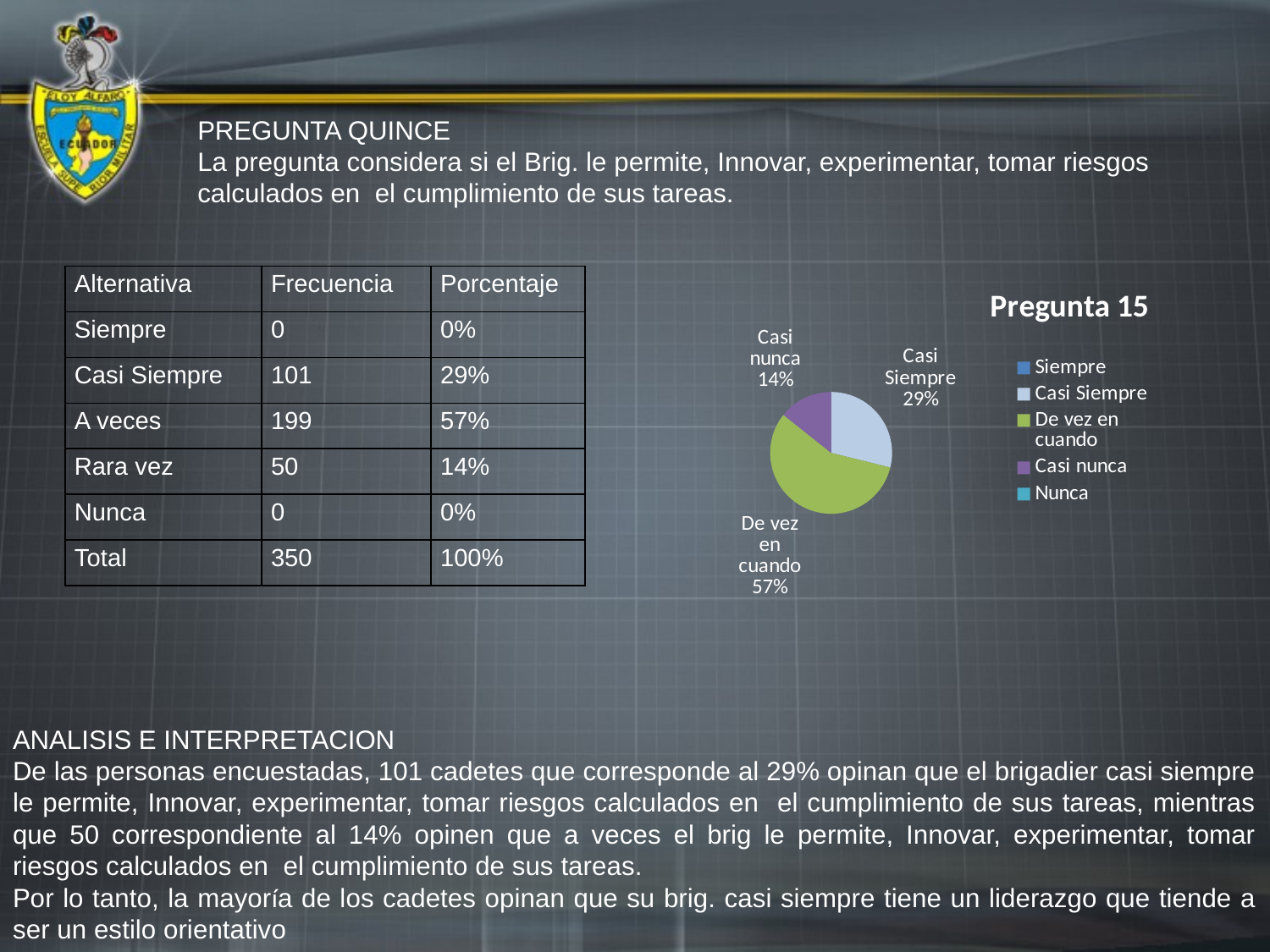
What type of chart is shown on the slide? pie chart What percentage does the 'De vez en cuando' slice show in the pie chart? 57% Which slice is larger, 'Casi Siempre' or 'Casi nunca'? Casi Siempre What is the difference in percentage points between the 'De vez en cuando' slice and the 'Casi Siempre' slice? 28 What is the title of the chart? Pregunta 15 How many slices are visible in the pie chart? 3 Which category has the largest slice in the pie chart? De vez en cuando How many entries does the chart legend list? 5 What percentage does the 'Casi Siempre' slice show in the pie chart? 29% What colour is the 'De vez en cuando' slice in the pie chart? green Which labelled slice is the smallest in the pie chart? Casi nunca What percentage does the 'Casi nunca' slice show in the pie chart? 14%